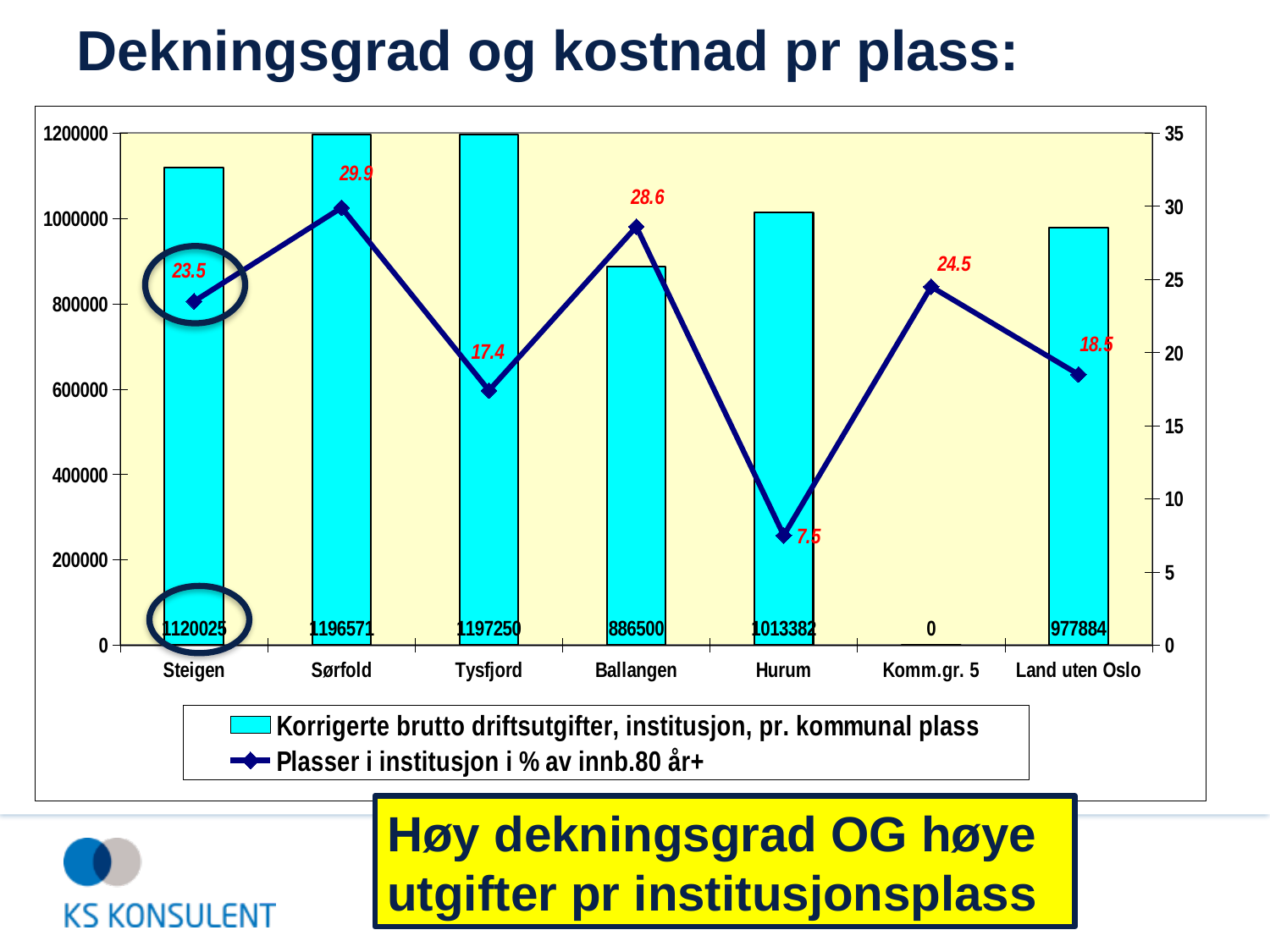
What is the value of Korrigerte brutto driftsutgifter, institusjon, pr. kommunal plass for Steigen? 1120025 Which has the larger Korrigerte brutto driftsutgifter, institusjon, pr. kommunal plass: Ballangen or Hurum? Hurum How many series does the legend list? 2 What is the difference between the Plasser i institusjon i % av innb.80 år+ values for Sørfold and Tysfjord? 12.5 What kind of chart is shown on the slide? Combined bar and line chart Which category has the lowest value of Plasser i institusjon i % av innb.80 år+? Hurum How many categories are shown on the x axis? 7 What is the value of Plasser i institusjon i % av innb.80 år+ for Sørfold? 29.9 What is the value of Plasser i institusjon i % av innb.80 år+ for Hurum? 7.5 What is the value of Korrigerte brutto driftsutgifter, institusjon, pr. kommunal plass for Komm.gr. 5? 0 What is the value of Korrigerte brutto driftsutgifter, institusjon, pr. kommunal plass for Land uten Oslo? 977884 Which category has the highest value of Korrigerte brutto driftsutgifter, institusjon, pr. kommunal plass? Tysfjord